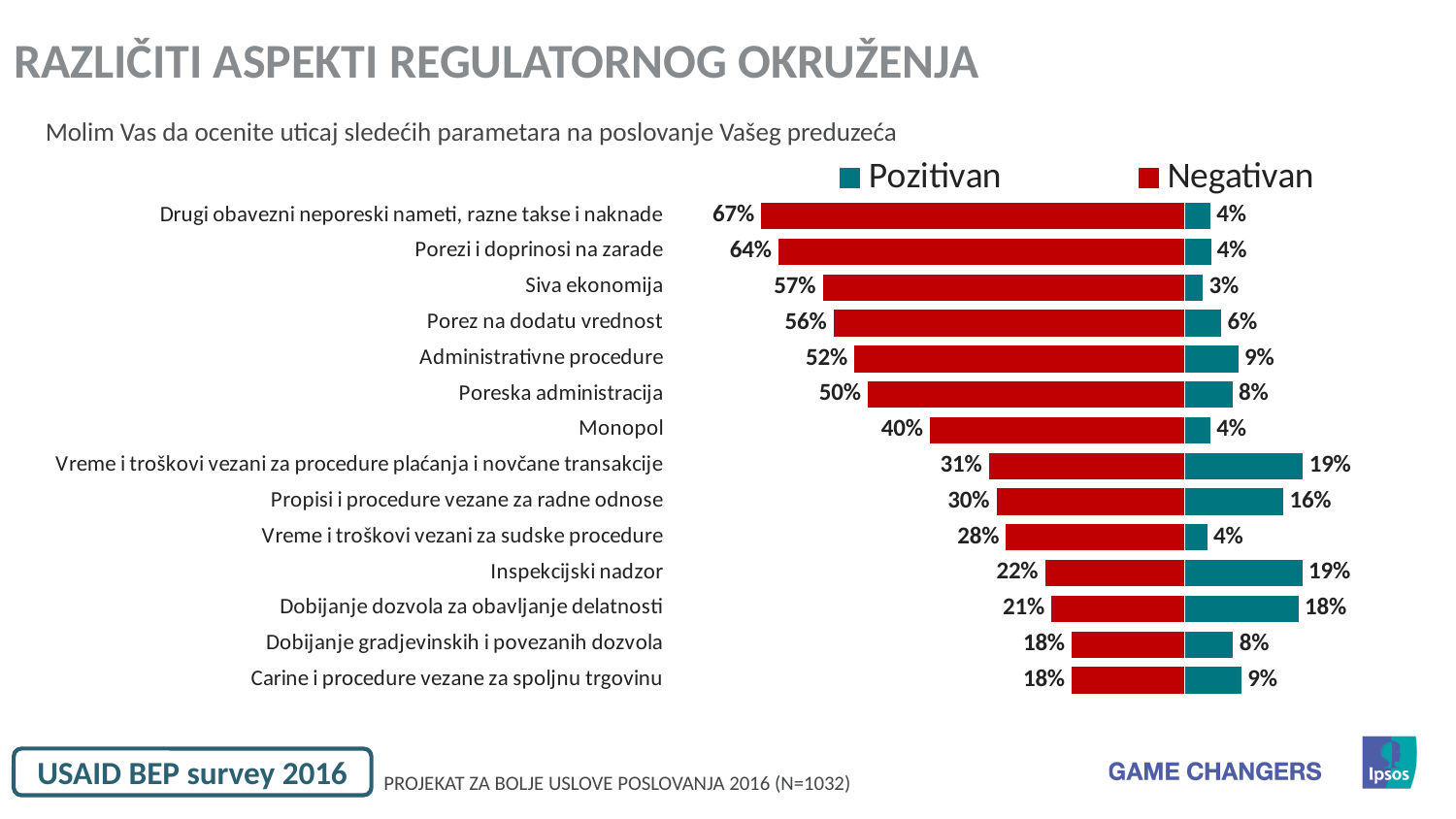
Which category has the highest Negativan value? Drugi obavezni neporeski nameti, razne takse i naknade What is the Negativan value for Drugi obavezni neporeski nameti, razne takse i naknade? 67% What is the Pozitivan value for Propisi i procedure vezane za radne odnose? 16% How many series does the legend list? 2 Which colour represents the Negativan series in the chart? Red What is the difference between the Negativan values for Porezi i doprinosi na zarade and Siva ekonomija? 7% Which is larger: the Pozitivan value for Poreska administracija or the Pozitivan value for Porez na dodatu vrednost? Poreska administracija What is the Negativan value for Monopol? 40% How many categories are shown in the chart? 14 What is the Pozitivan value for Administrativne procedure? 9% What kind of chart is shown on the slide? Bar chart Which category has the lowest Pozitivan value? Siva ekonomija